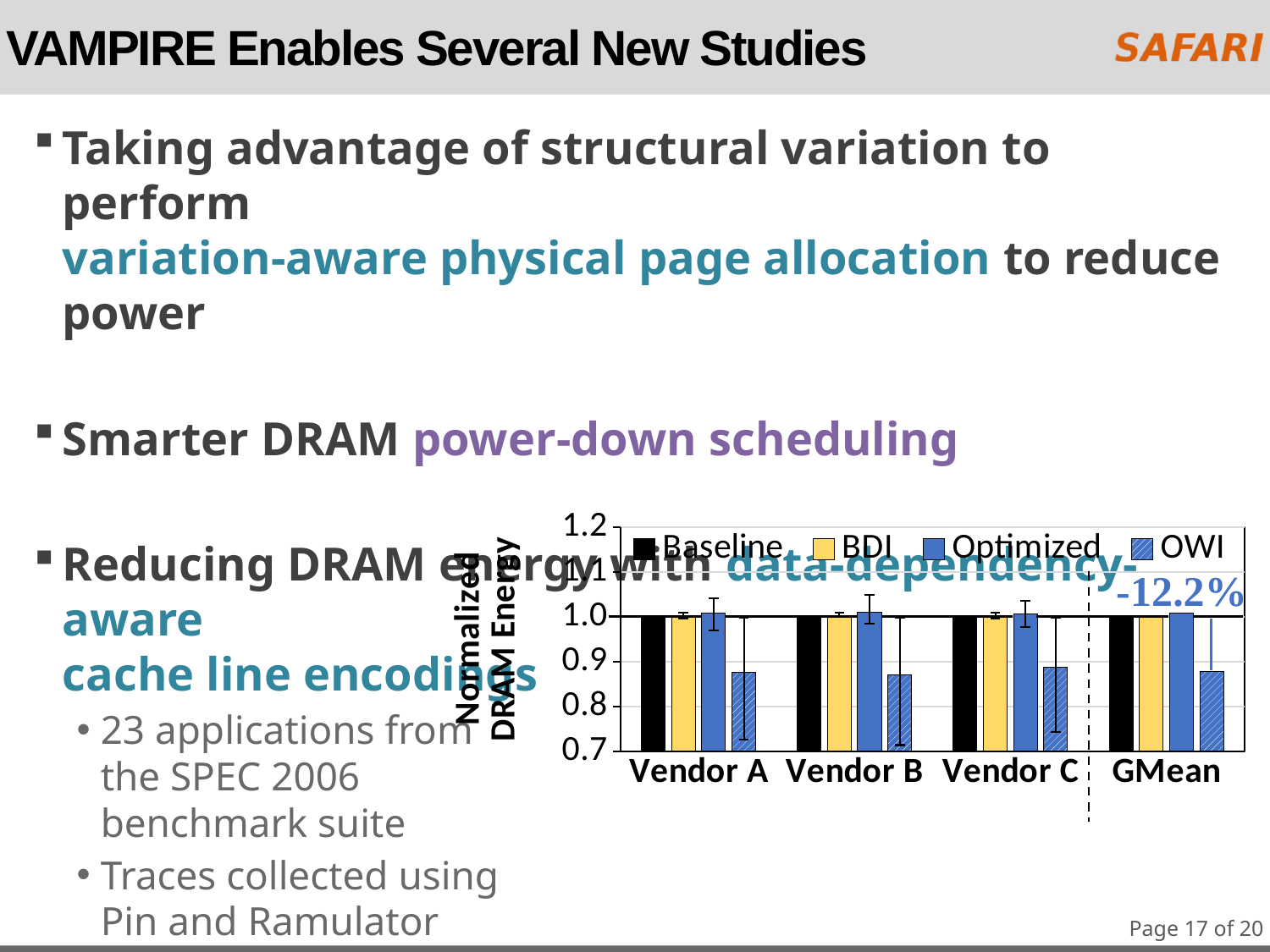
Which series has the lowest value for GMean? OWI Is the OWI value for Vendor B greater or less than 0.9? less Is the Optimized value for Vendor C greater or less than 0.9? greater What kind of chart is shown on the slide? bar chart What percentage reduction is annotated next to the GMean bars in the chart? -12.2% How many categories are shown on the x axis of the chart? 4 Which is larger for GMean, the Optimized value or the OWI value? Optimized Is the OWI value for Vendor A greater or less than 0.8? greater How many series does the chart's legend list? 4 Which is larger for Vendor A, the Baseline value or the OWI value? Baseline Which series has the lowest value for Vendor B? OWI What is the label of the chart's y axis? Normalized DRAM Energy